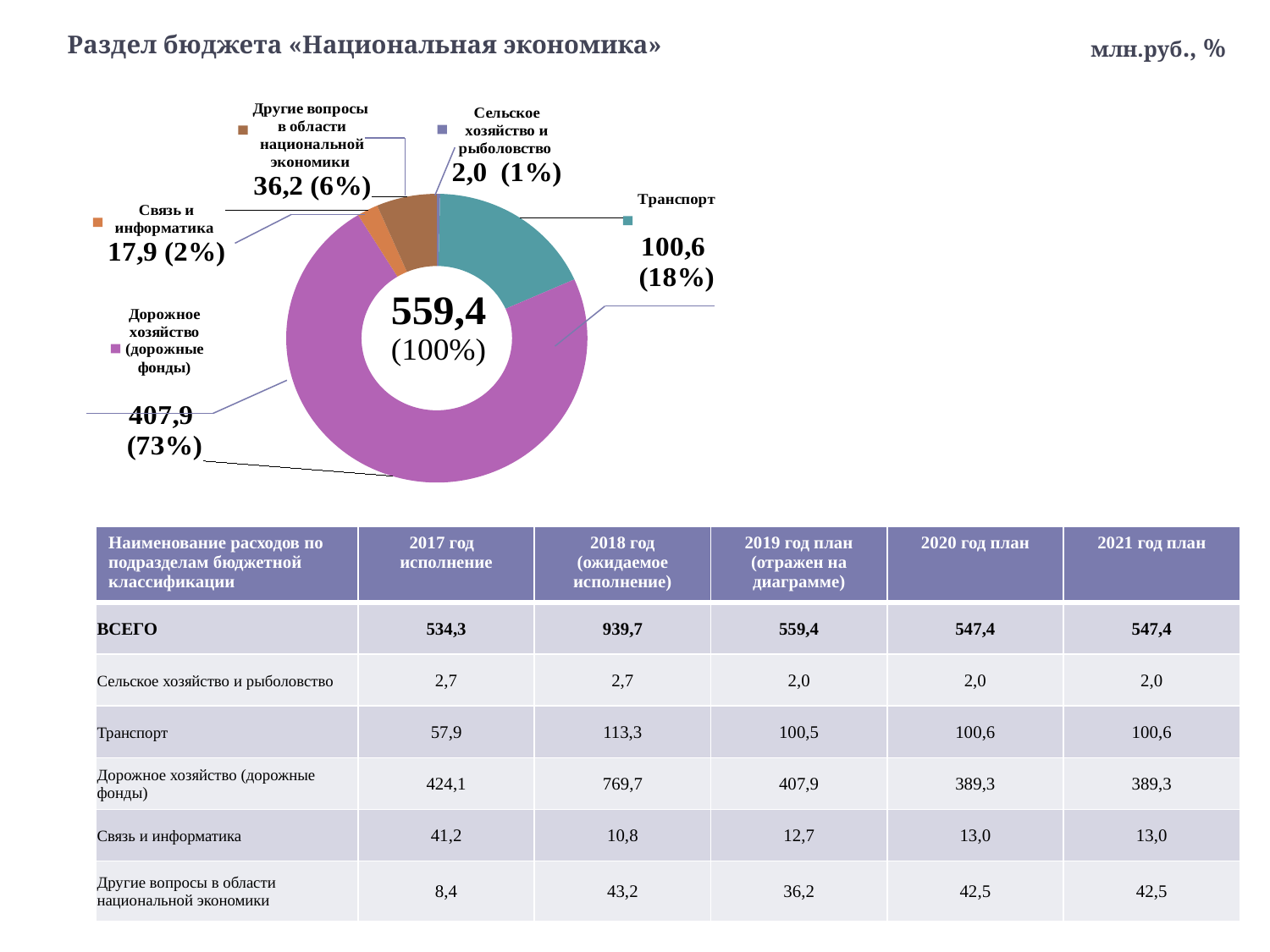
Which category has the smallest slice of the chart? Сельское хозяйство и рыболовство Which category has the largest slice of the chart? Дорожное хозяйство (дорожные фонды) What value is shown for Другие вопросы в области национальной экономики on the chart? 36,2 What total value is shown in the centre of the chart? 559,4 What share of the chart does Транспорт represent? 18% What value is shown for Дорожное хозяйство (дорожные фонды) on the chart? 407,9 What share of the chart does Сельское хозяйство и рыболовство represent? 1% How many categories are shown in the chart? 5 What value is shown for Транспорт on the chart? 100,6 Which is larger on the chart, Другие вопросы в области национальной экономики or Связь и информатика? Другие вопросы в области национальной экономики What type of chart is shown on the slide? Doughnut (pie) chart What value is shown for Связь и информатика on the chart? 17,9